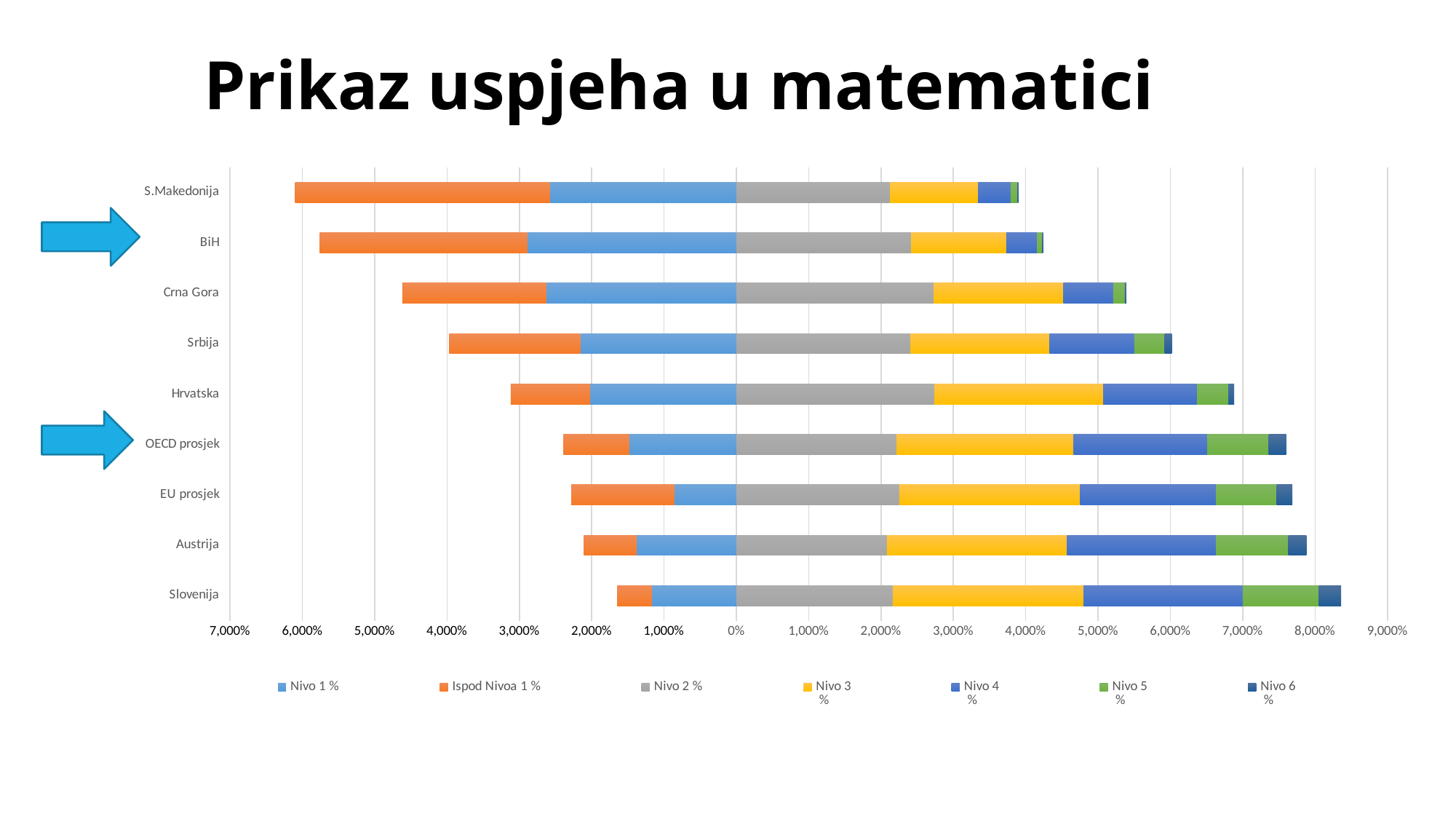
Which category's bar extends furthest to the left on the chart? S.Makedonija How many series does the chart legend list? 7 Which category has the shortest orange (Ispod Nivoa 1 %) segment? Slovenija Which legend entry is shown in orange? Ispod Nivoa 1 % Does the right-hand end of the Slovenija bar lie greater or less than 8,000% on the axis? greater Which bar extends further to the right, Hrvatska or Srbija? Hrvatska What is the title of the slide containing the chart? Prikaz uspjeha u matematici Which category has the longest orange (Ispod Nivoa 1 %) segment? S.Makedonija How many countries or averages are listed on the vertical axis of the chart? 9 What kind of chart is shown on the slide? Stacked bar chart Which category's bar extends furthest to the right on the chart? Slovenija Does the right-hand end of the S.Makedonija bar lie greater or less than 4,000% on the axis? less